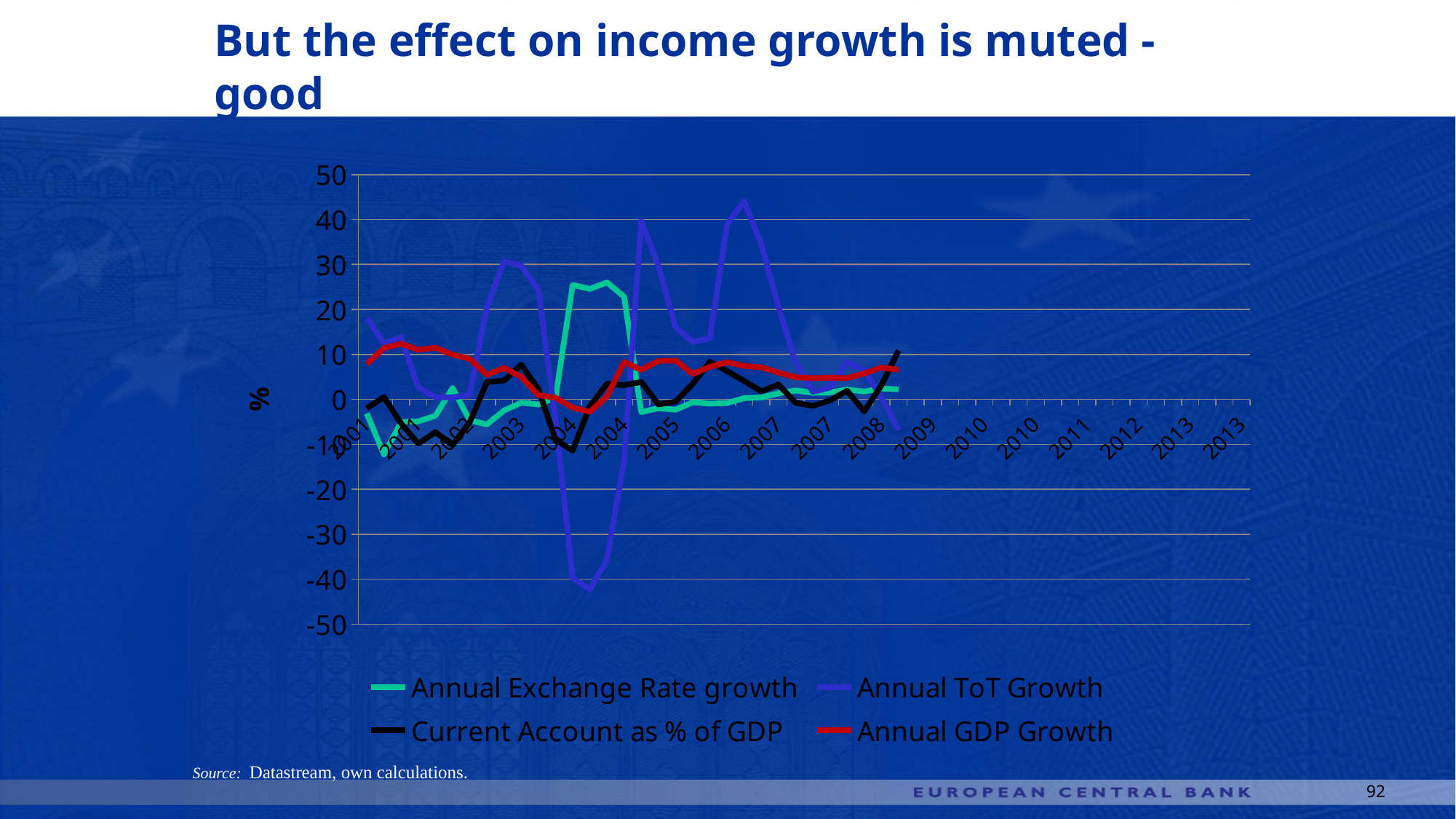
What kind of chart is shown on the slide? line chart Is the peak value of Annual Exchange Rate growth around 2004 greater or less than 20? greater Is the peak value of Annual ToT Growth around 2006 greater or less than 40? greater Is the lowest value of Annual ToT Growth around 2004 greater or less than -40? less Which series reaches the highest value on the chart? Annual ToT Growth Around 2006, which series is higher: Annual ToT Growth or Annual GDP Growth? Annual ToT Growth How many series does the legend list? 4 What label is shown on the vertical axis of the chart? % What is the title of the slide containing the chart? But the effect on income growth is muted - good Which series reaches the lowest value on the chart? Annual ToT Growth